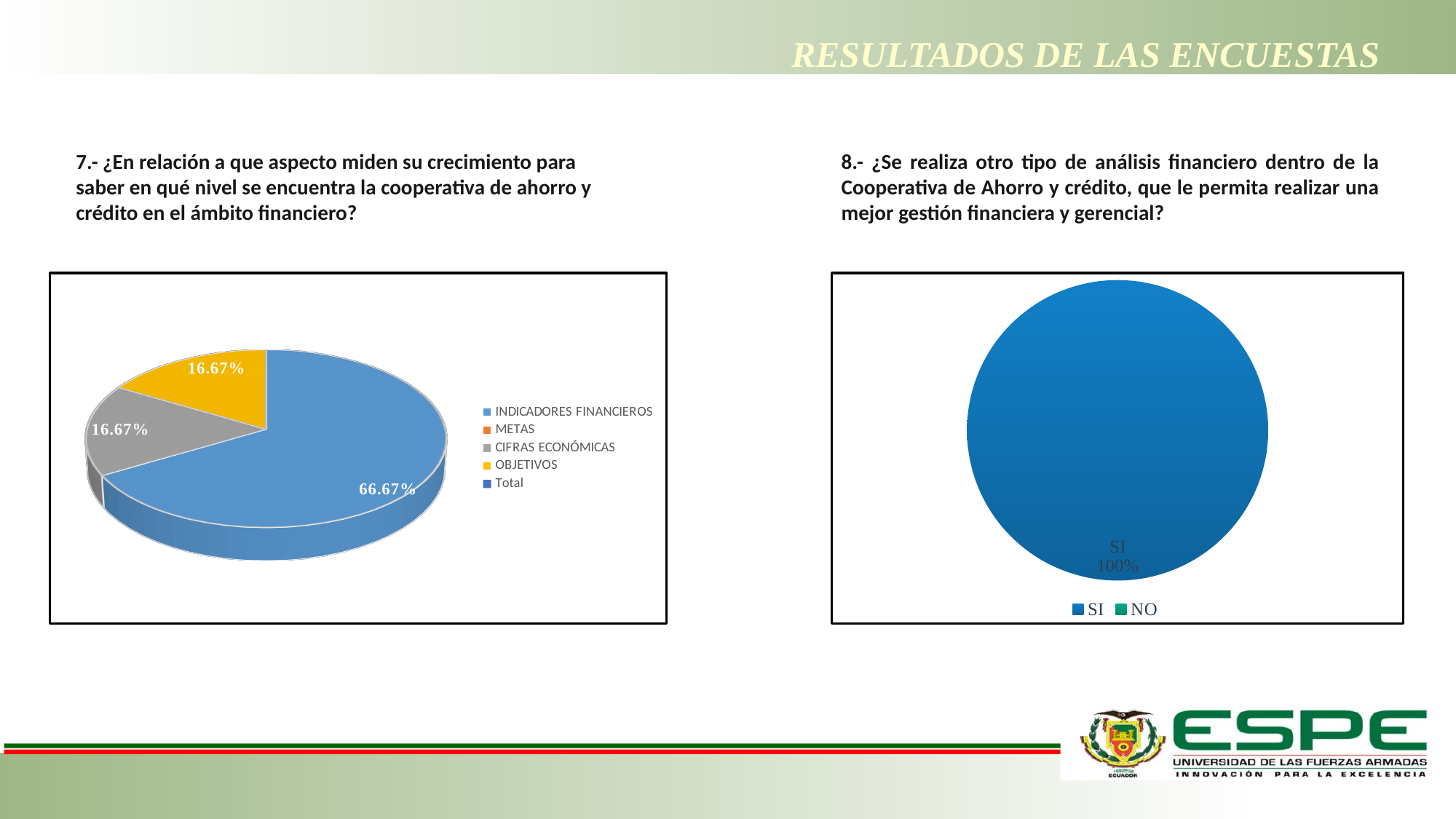
On the left chart (question 7), what colour is the OBJETIVOS slice? Yellow On the left chart (question 7), what is the difference between the INDICADORES FINANCIEROS slice and the OBJETIVOS slice? 50.00% On the left chart (question 7), which category has the largest slice? INDICADORES FINANCIEROS What kind of chart is shown on the left (question 7)? Pie chart On the left chart (question 7), what share of the pie is INDICADORES FINANCIEROS? 66.67% On the left chart (question 7), which is larger, the INDICADORES FINANCIEROS slice or the CIFRAS ECONÓMICAS slice? INDICADORES FINANCIEROS On the left chart (question 7), how many entries does the legend list? 5 On the right chart (question 8), how many entries does the legend list? 2 What kind of chart is shown on the right (question 8)? Pie chart On the left chart (question 7), what share of the pie is CIFRAS ECONÓMICAS? 16.67% On the right chart (question 8), what share of the pie is SI? 100% On the left chart (question 7), what share of the pie is OBJETIVOS? 16.67%